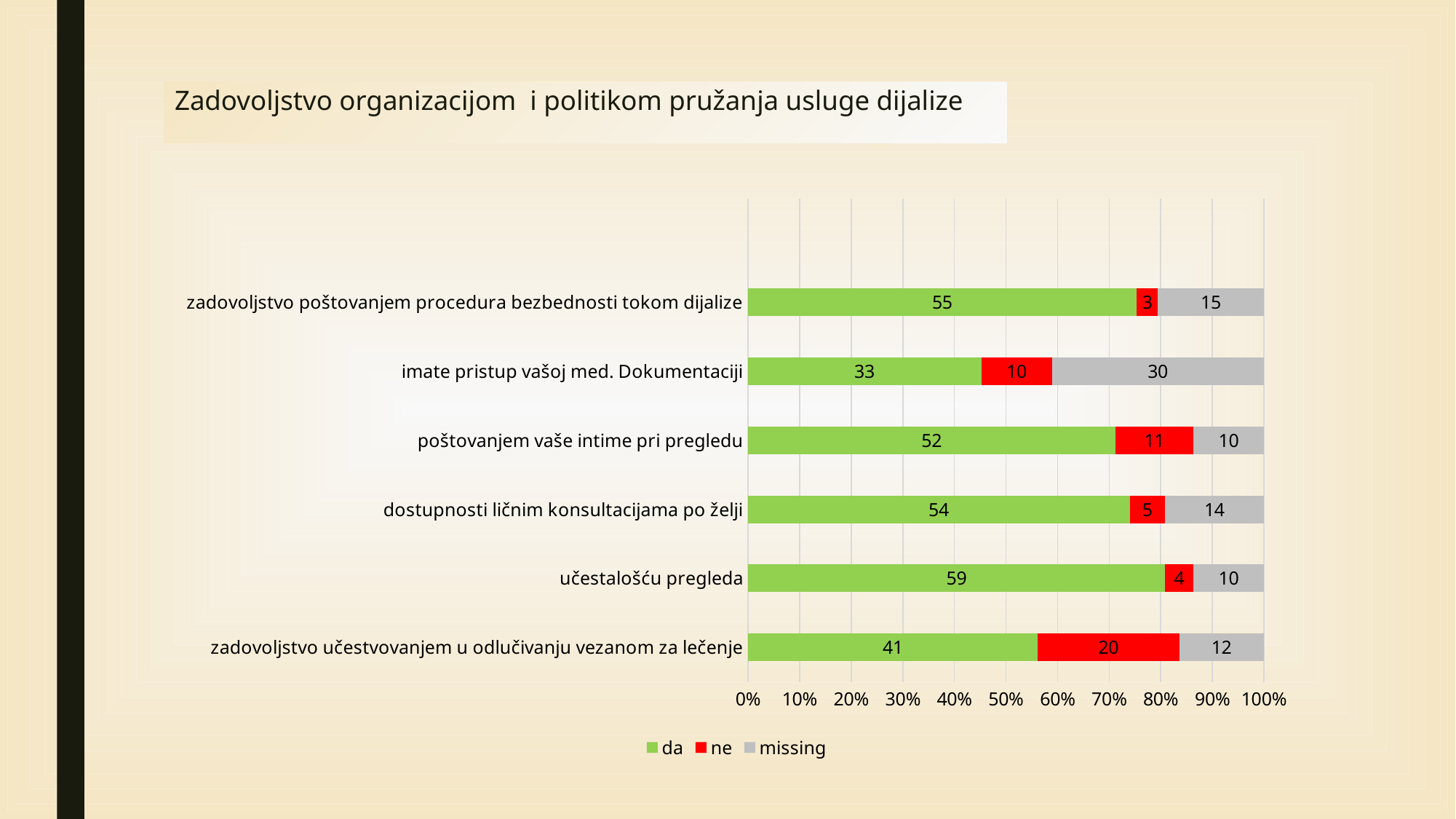
How many series does the legend list? 3 What kind of chart is shown on the slide? Stacked bar chart Which category has the highest 'ne' value? zadovoljstvo učestvovanjem u odlučivanju vezanom za lečenje Which category has the lowest 'da' value? imate pristup vašoj med. Dokumentaciji How many categories are shown on the chart? 6 What is the 'da' value for 'učestalošću pregleda'? 59 Which is larger: the 'ne' value for 'poštovanjem vaše intime pri pregledu' or the 'ne' value for 'dostupnosti ličnim konsultacijama po želji'? poštovanjem vaše intime pri pregledu Which category has the highest 'da' value? učestalošću pregleda What is the 'ne' value for 'zadovoljstvo učestvovanjem u odlučivanju vezanom za lečenje'? 20 What is the 'missing' value for 'imate pristup vašoj med. Dokumentaciji'? 30 What is the total of the stacked bar for 'zadovoljstvo poštovanjem procedura bezbednosti tokom dijalize'? 73 What is the difference between the 'da' values for 'učestalošću pregleda' and 'imate pristup vašoj med. Dokumentaciji'? 26